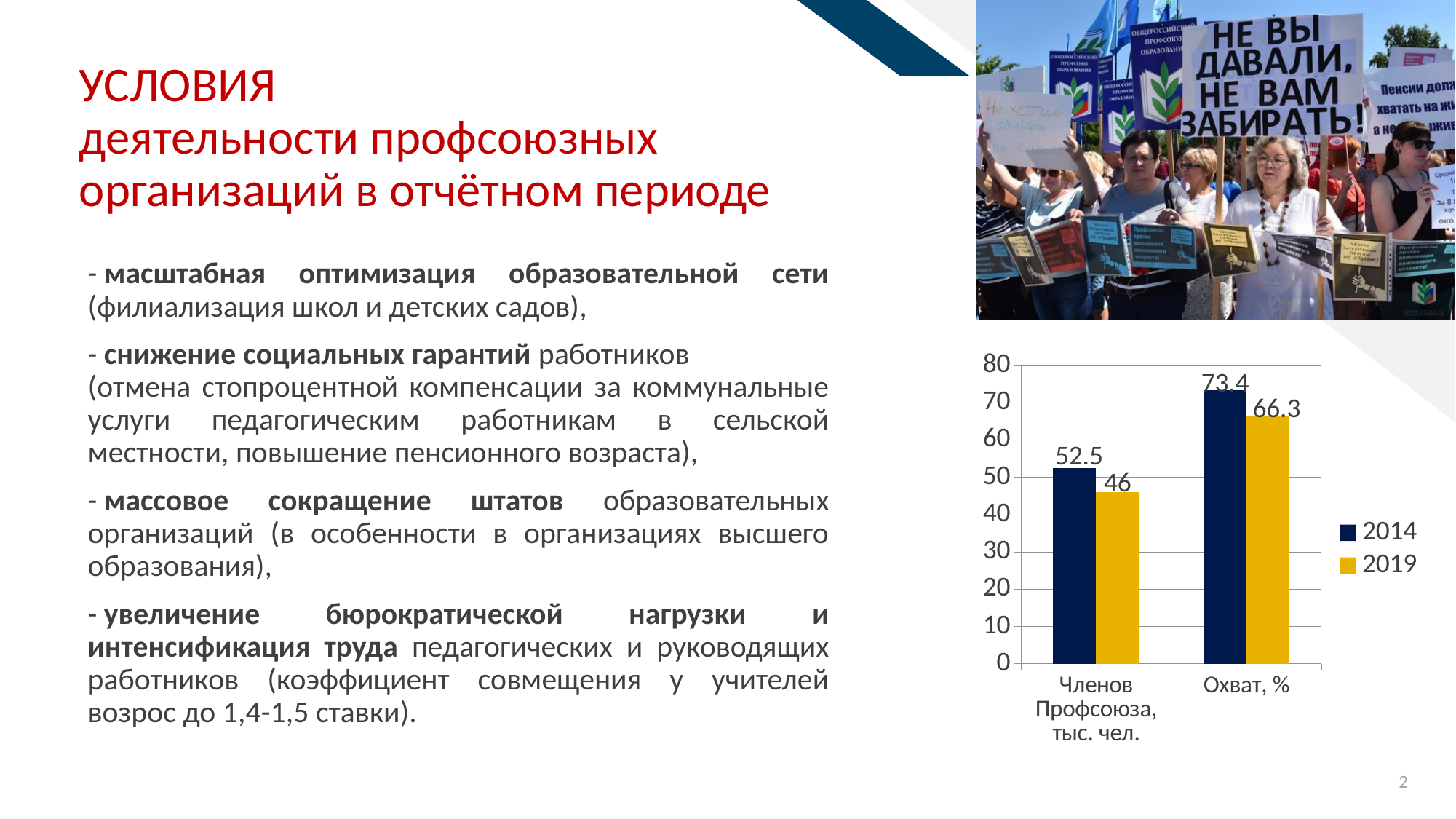
How many series does the chart legend list? 2 What is the value for 2014 in the category "Членов Профсоюза, тыс. чел."? 52.5 What kind of chart is shown on the slide? Bar chart What is the difference between the 2014 and 2019 values in the category "Охват, %"? 7.1 What is the value for 2019 in the category "Членов Профсоюза, тыс. чел."? 46 How many categories are shown on the x axis of the chart? 2 What is the value for 2014 in the category "Охват, %"? 73.4 Which series has the higher value in the category "Охват, %", 2014 or 2019? 2014 Which bar in the chart has the highest value? 2014, Охват, % Which bar in the chart has the lowest value? 2019, Членов Профсоюза, тыс. чел. What is the value for 2019 in the category "Охват, %"? 66.3 What is the difference between the 2014 and 2019 values in the category "Членов Профсоюза, тыс. чел."? 6.5